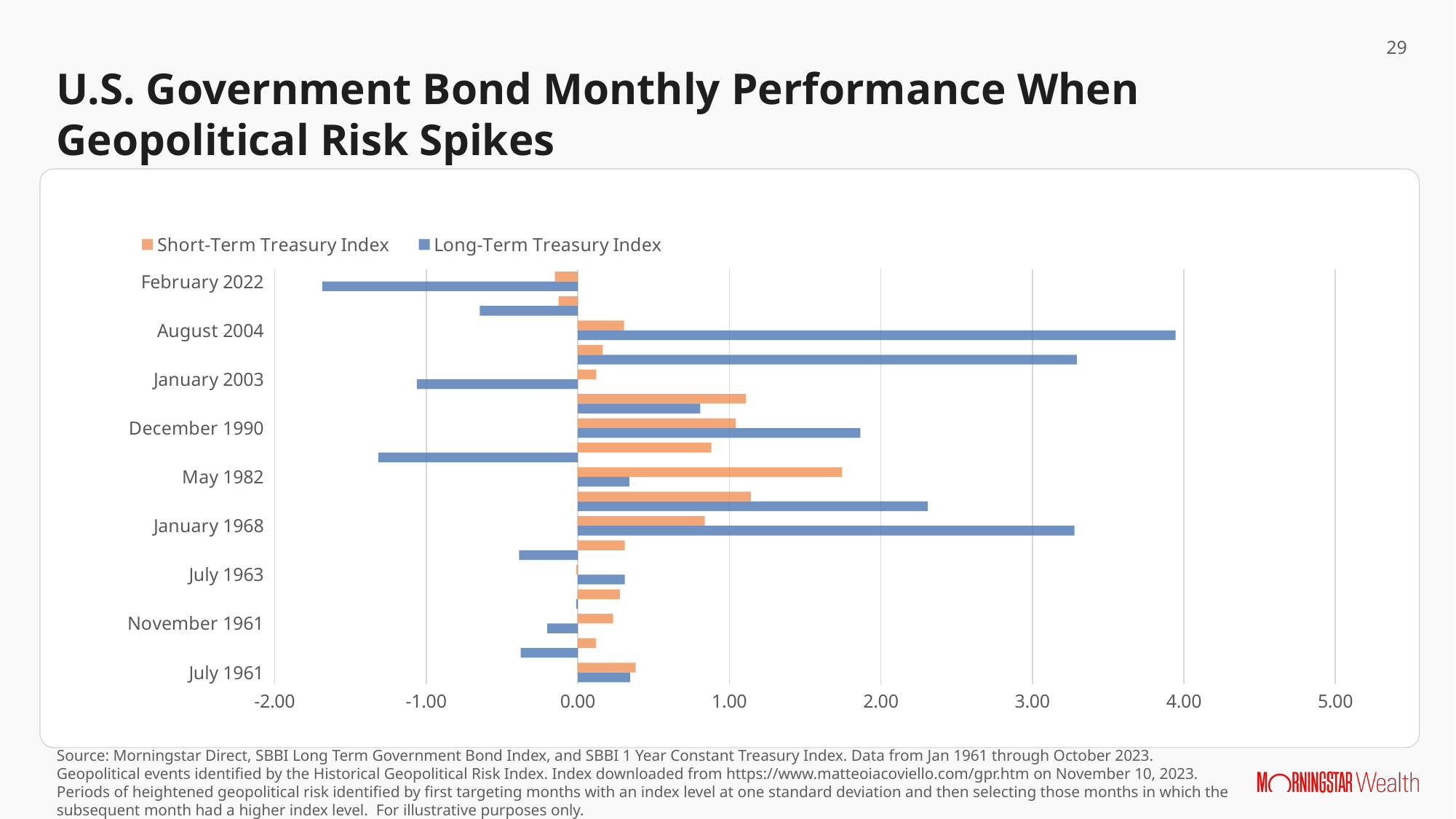
Is the Short-Term Treasury Index value for August 2004 greater or less than 1.00? less What kind of chart is shown on the slide? bar chart Is the Long-Term Treasury Index value for January 2003 greater or less than 0.00? less Which series is shown in blue? Long-Term Treasury Index Is the Short-Term Treasury Index value for May 1982 greater or less than 1.00? greater For May 1982, which series has the larger value, Short-Term Treasury Index or Long-Term Treasury Index? Short-Term Treasury Index Among the labeled months, which has the highest Long-Term Treasury Index value? August 2004 How many series does the legend list? 2 For August 2004, which series has the larger value, Short-Term Treasury Index or Long-Term Treasury Index? Long-Term Treasury Index How many month labels are shown on the vertical axis? 9